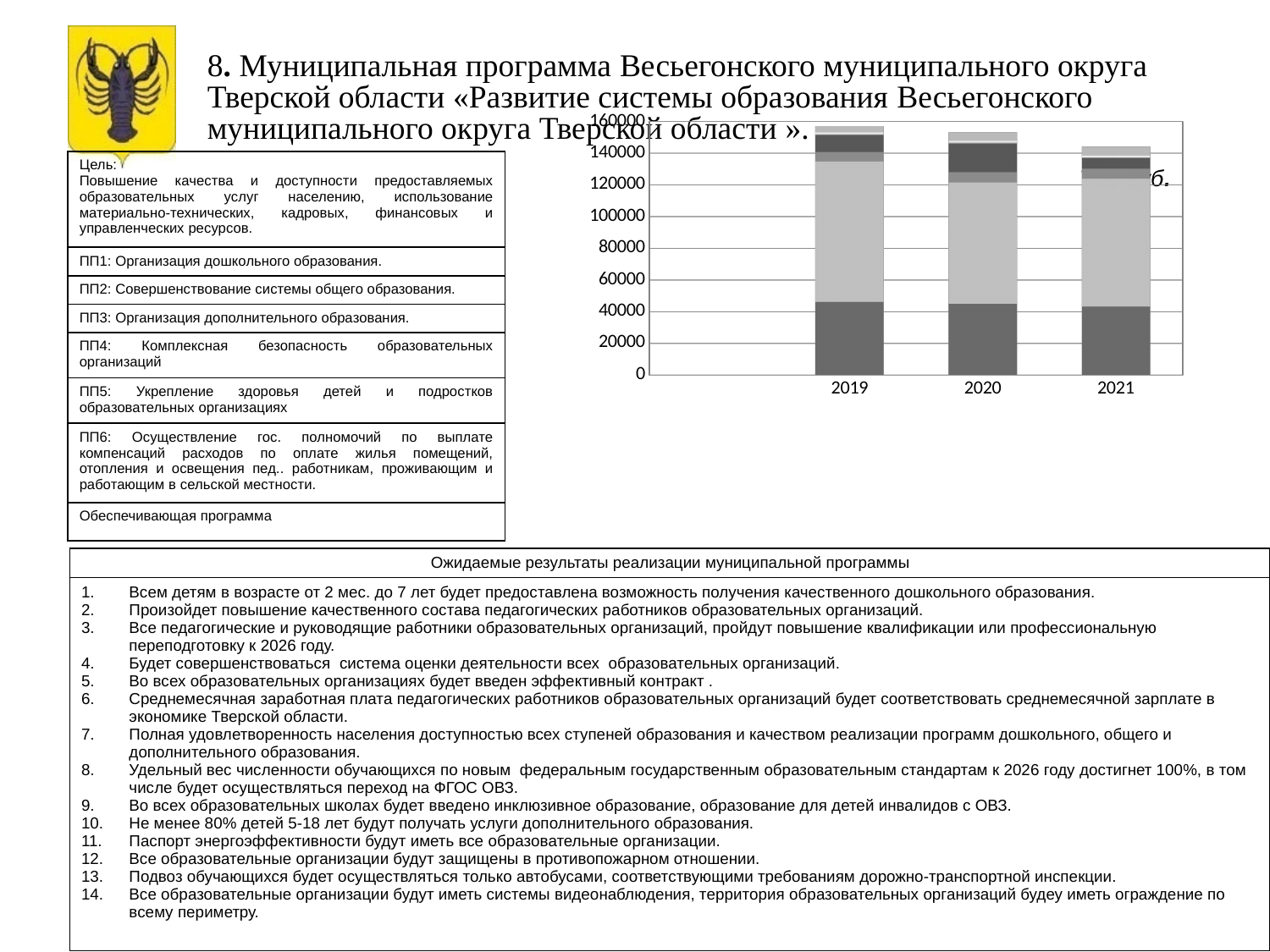
Is the bottom (dark grey) segment of the 2019 bar greater or less than 40000? greater What is the highest value shown on the y axis of the chart? 160000 How many years (categories) are shown on the x axis of the chart? 3 What kind of chart is shown on the slide? stacked bar chart Is the total height of the 2021 bar greater or less than 160000? less Which stacked bar is taller overall, 2019 or 2021? 2019 Which years are shown on the x axis of the chart? 2019, 2020, 2021 Which year has the tallest stacked bar in the chart? 2019 Is the bottom (dark grey) segment of the 2021 bar greater or less than 60000? less Which year has the shortest stacked bar in the chart? 2021 Do the total heights of the stacked bars rise or fall from 2019 to 2021? fall